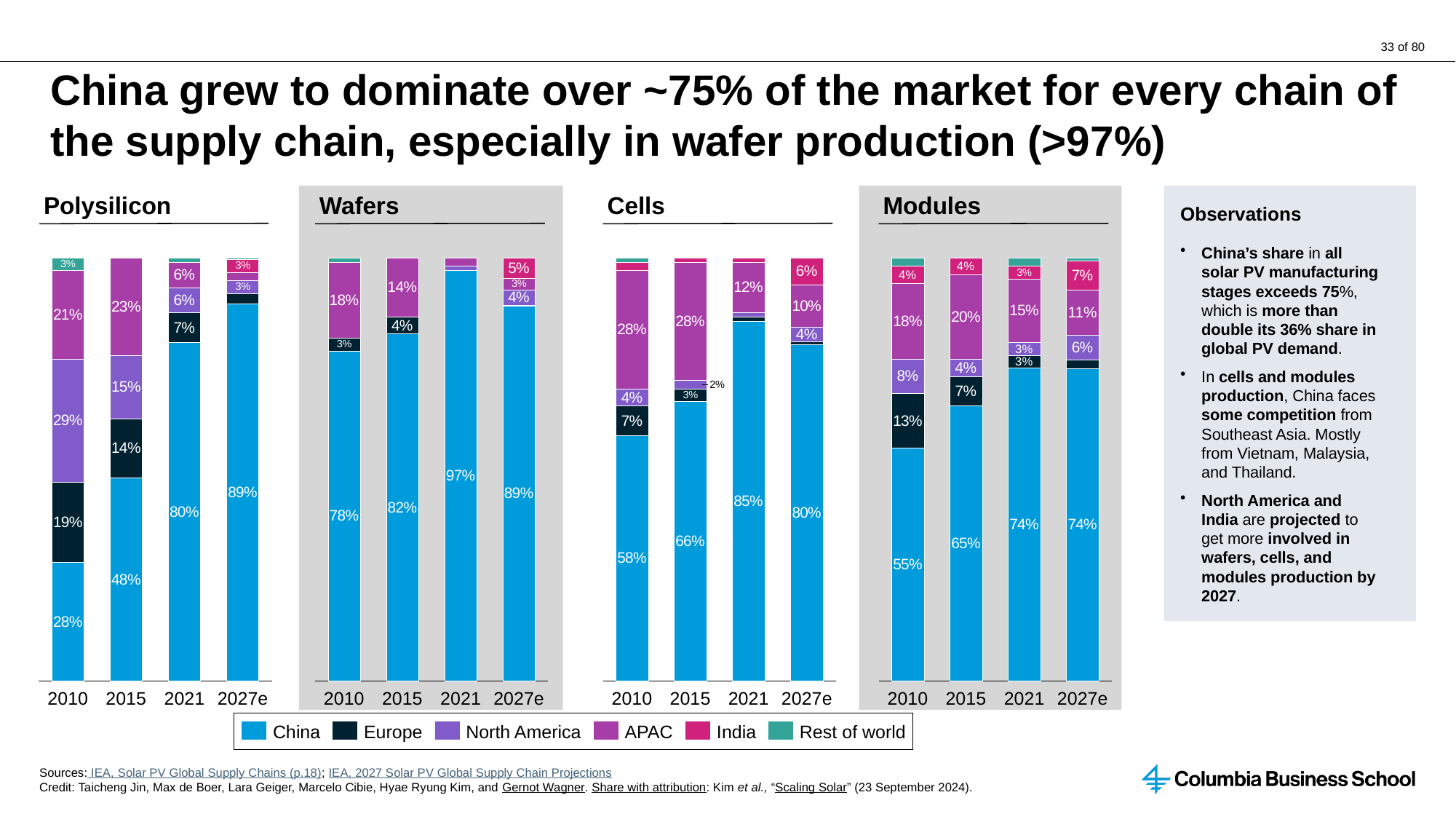
In the Wafers chart, what is China's share in 2021? 97% In the Wafers chart, does China's share rise or fall from 2010 to 2021? Rise How many years are shown on the x axis of the Polysilicon chart? 4 In the Cells chart, what is APAC's share in 2015? 28% In the Polysilicon chart, what is China's share in 2010? 28% In the Wafers chart, is APAC's share larger in 2010 or in 2015? 2010 How many series does the legend list? 6 In the Modules chart, what is Europe's share in 2010? 13% What kind of chart is the Cells chart? Stacked bar chart In the Polysilicon chart, which year has the highest China share? 2027e In the Cells chart, which year has the lowest China share? 2010 In the Modules chart, what is the difference between China's share in 2021 and in 2010? 19%